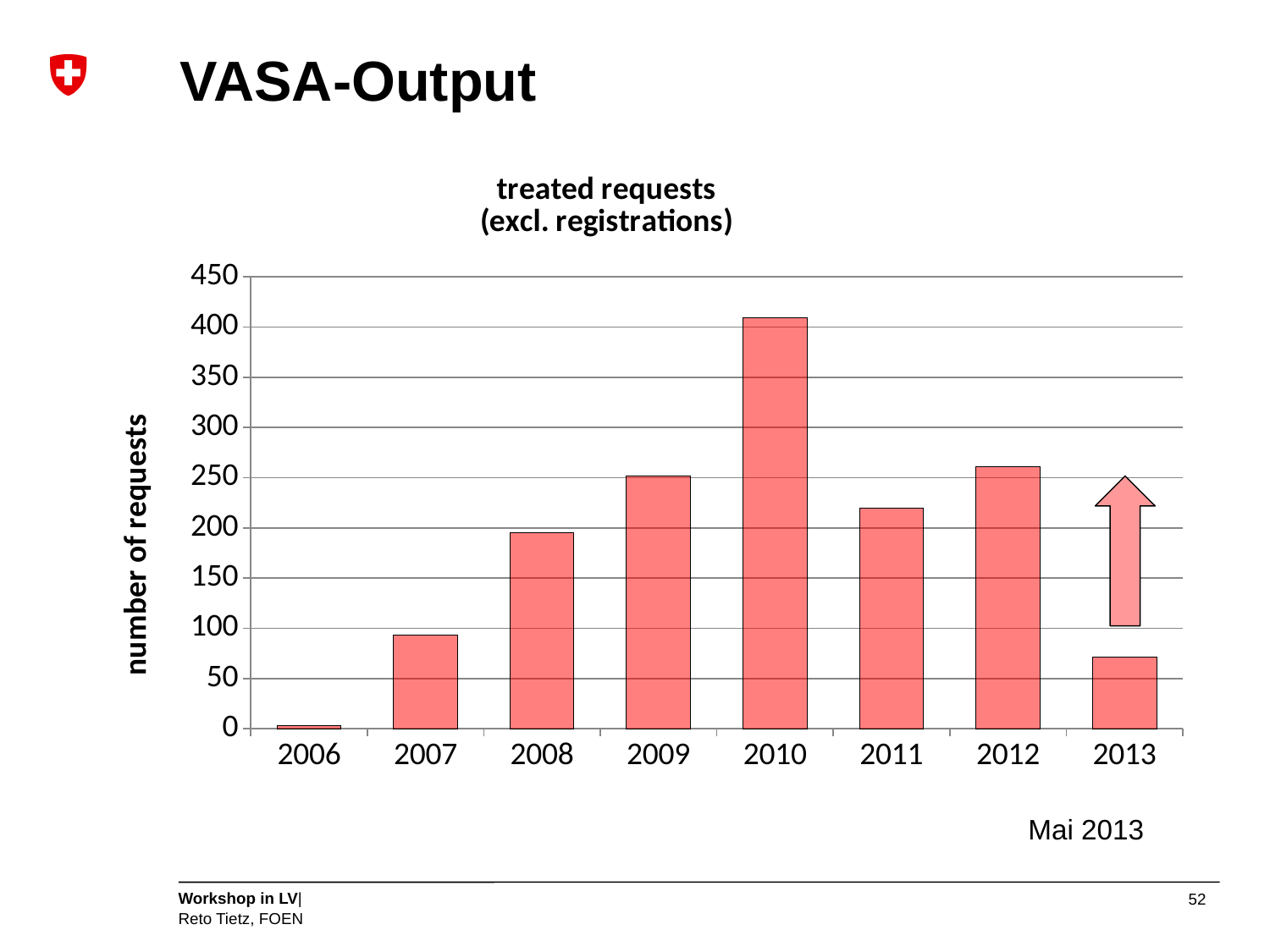
Do the values rise or fall from 2006 to 2010? rise Is the value for 2010 greater or less than 400? greater Is the value for 2007 greater or less than 100? less Is the value for 2013 greater or less than 50? greater What is the title of the chart? treated requests (excl. registrations) How many years are shown on the x axis of the chart? 8 Which year has the highest number of treated requests? 2010 Which year has the lowest number of treated requests? 2006 What kind of chart is shown on the slide? bar chart Which year has more treated requests, 2009 or 2011? 2009 What is the label on the vertical axis of the chart? number of requests